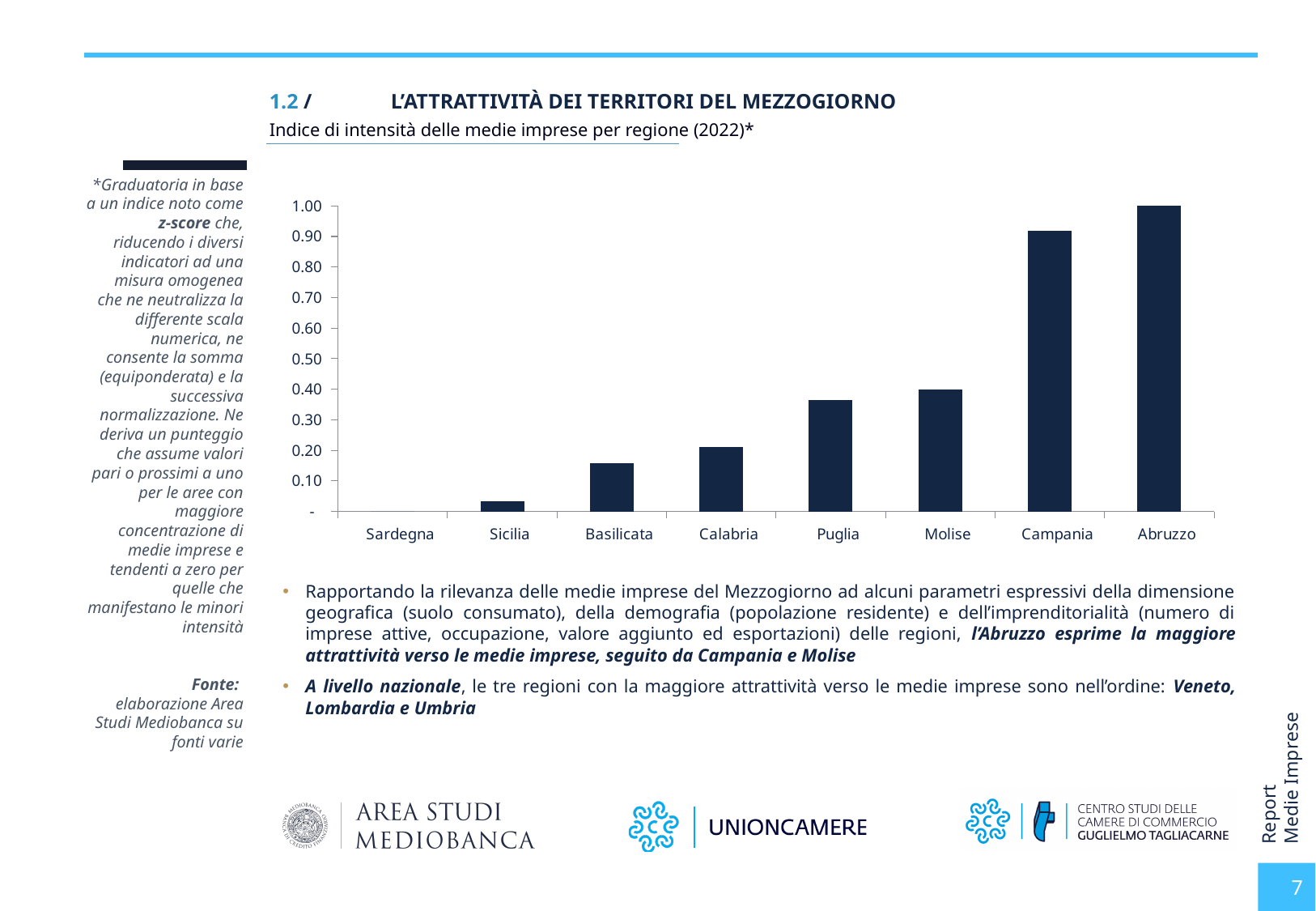
What kind of chart is shown on the slide? Bar chart What is the title of the chart? Indice di intensità delle medie imprese per regione (2022)* How many regions are shown on the x axis of the chart? 8 What is the index value for Abruzzo? 1.00 Which has a higher index value, Campania or Molise? Campania Which region has the lowest index value in the chart? Sardegna Is the value for Puglia greater or less than 0.40? less Is the value for Basilicata greater or less than 0.10? greater Do the values rise or fall moving from left to right along the x axis? Rise Is the value for Campania greater or less than 0.80? greater Which region has the highest index value in the chart? Abruzzo